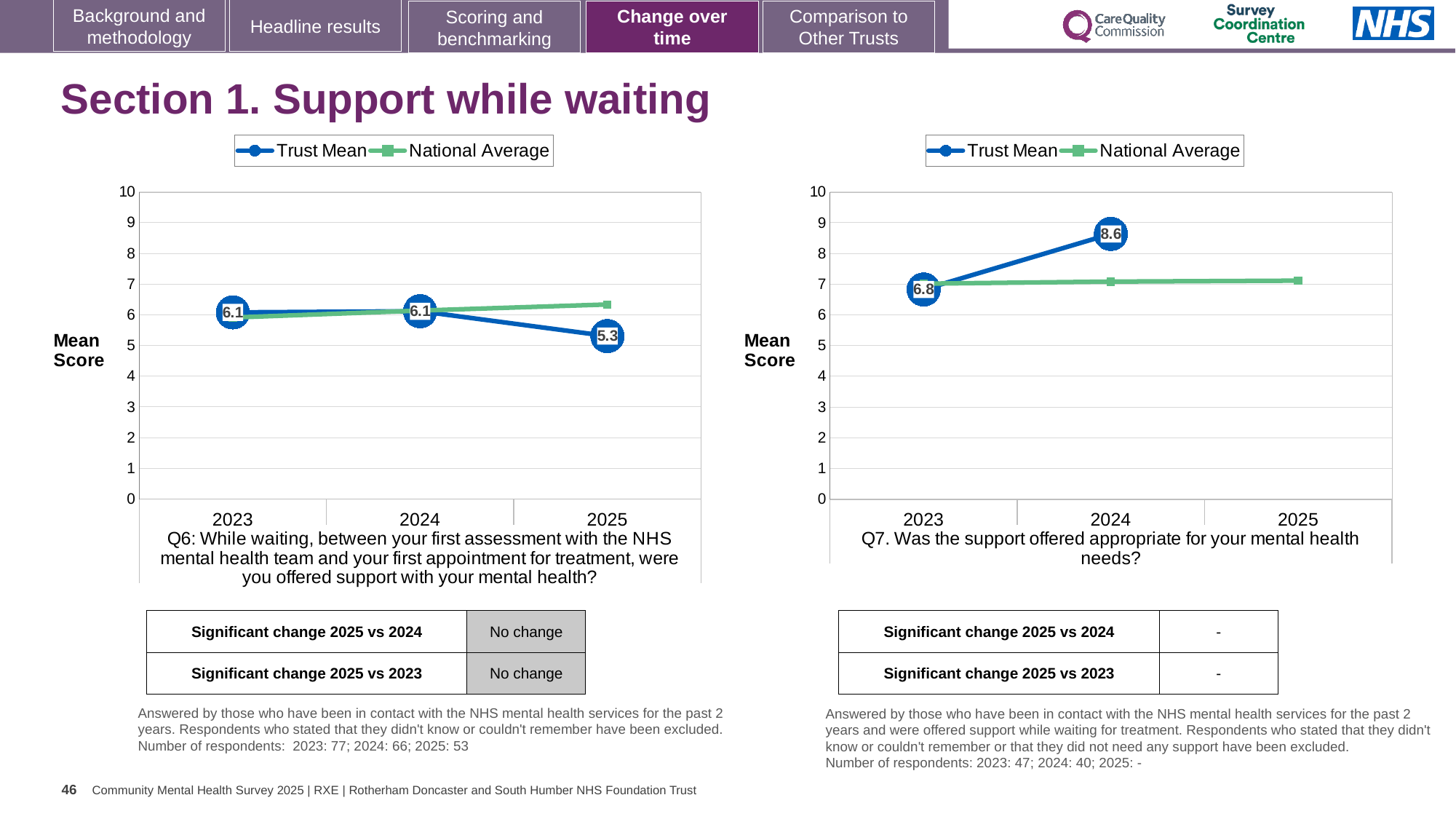
In the Q6 chart on the left, what is the difference between the Trust Mean scores for 2024 and 2025? 0.8 In the Q6 chart on the left, is the National Average for 2025 greater or less than 6? greater In the Q6 chart on the left, which year has the lowest Trust Mean score? 2025 In the Q7 chart on the right, what is the Trust Mean score for 2023? 6.8 In the Q7 chart on the right, which year has the highest Trust Mean score? 2024 How many series does the legend of the Q6 chart on the left list? 2 What type of chart is the Q7 chart on the right? Line chart In the Q7 chart on the right, by how much did the Trust Mean score increase from 2023 to 2024? 1.8 In the Q7 chart on the right, is the National Average for 2024 greater or less than 8? less In the Q7 chart on the right, what is the Trust Mean score for 2024? 8.6 In the Q6 chart on the left, what is the Trust Mean score for 2025? 5.3 In the Q6 chart on the left, what is the Trust Mean score for 2023? 6.1